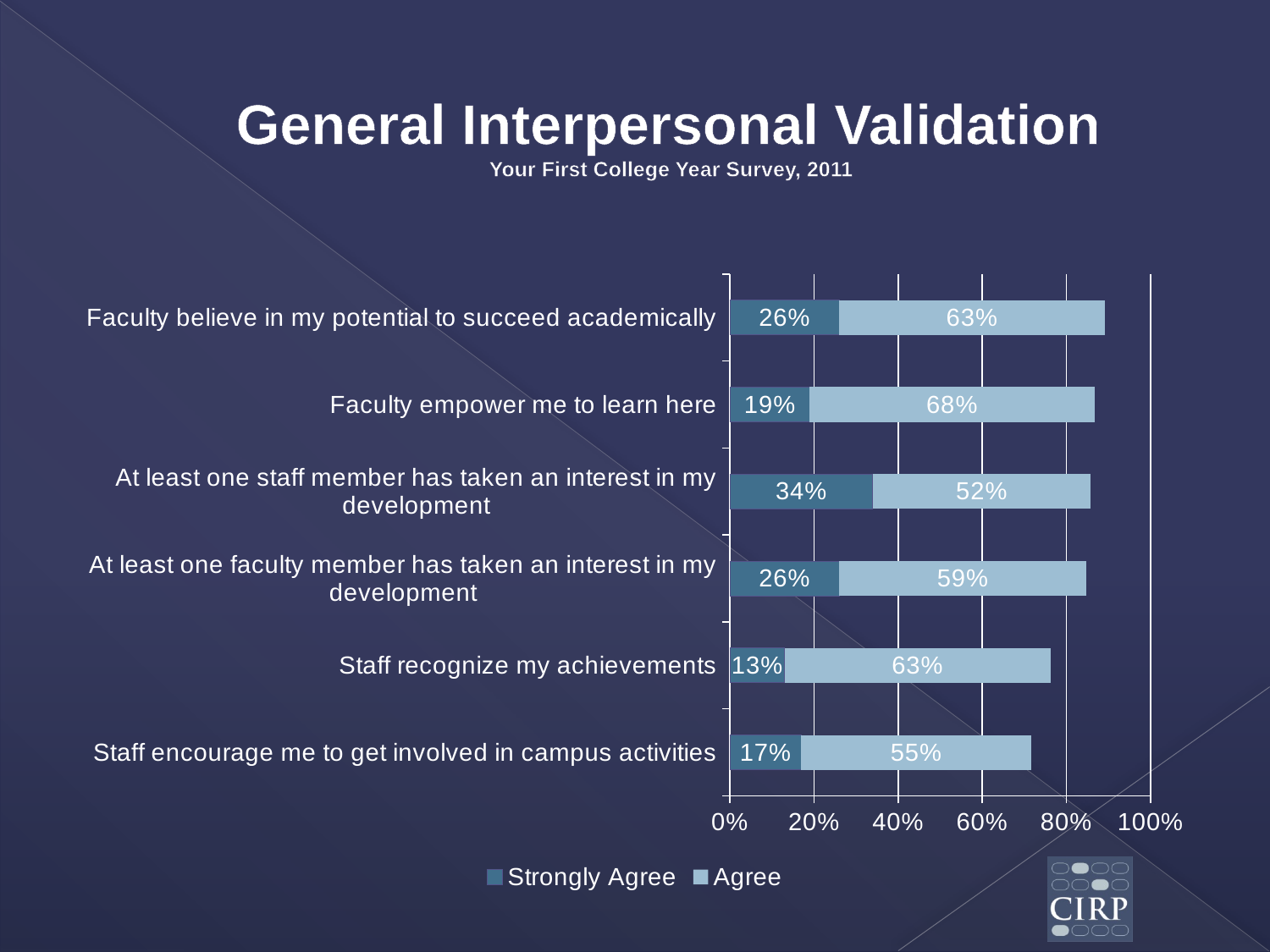
What is the difference between the Agree values for "Faculty empower me to learn here" and "At least one staff member has taken an interest in my development"? 16% Which statement has the lowest Strongly Agree percentage? Staff recognize my achievements What is the combined Strongly Agree and Agree total for "Faculty believe in my potential to succeed academically"? 89% How many series does the legend list? 2 Which statement has the highest Strongly Agree percentage? At least one staff member has taken an interest in my development How many statements are shown in the chart? 6 What is the Agree value for "Faculty empower me to learn here"? 68% What type of chart is shown on the slide? Stacked bar chart What percentage of students strongly agree that faculty believe in their potential to succeed academically? 26% What is the combined Strongly Agree and Agree total for "Staff recognize my achievements"? 76% What percentage of students agree that staff encourage them to get involved in campus activities? 55% Which has a larger Strongly Agree value: "Faculty empower me to learn here" or "Staff encourage me to get involved in campus activities"? Faculty empower me to learn here